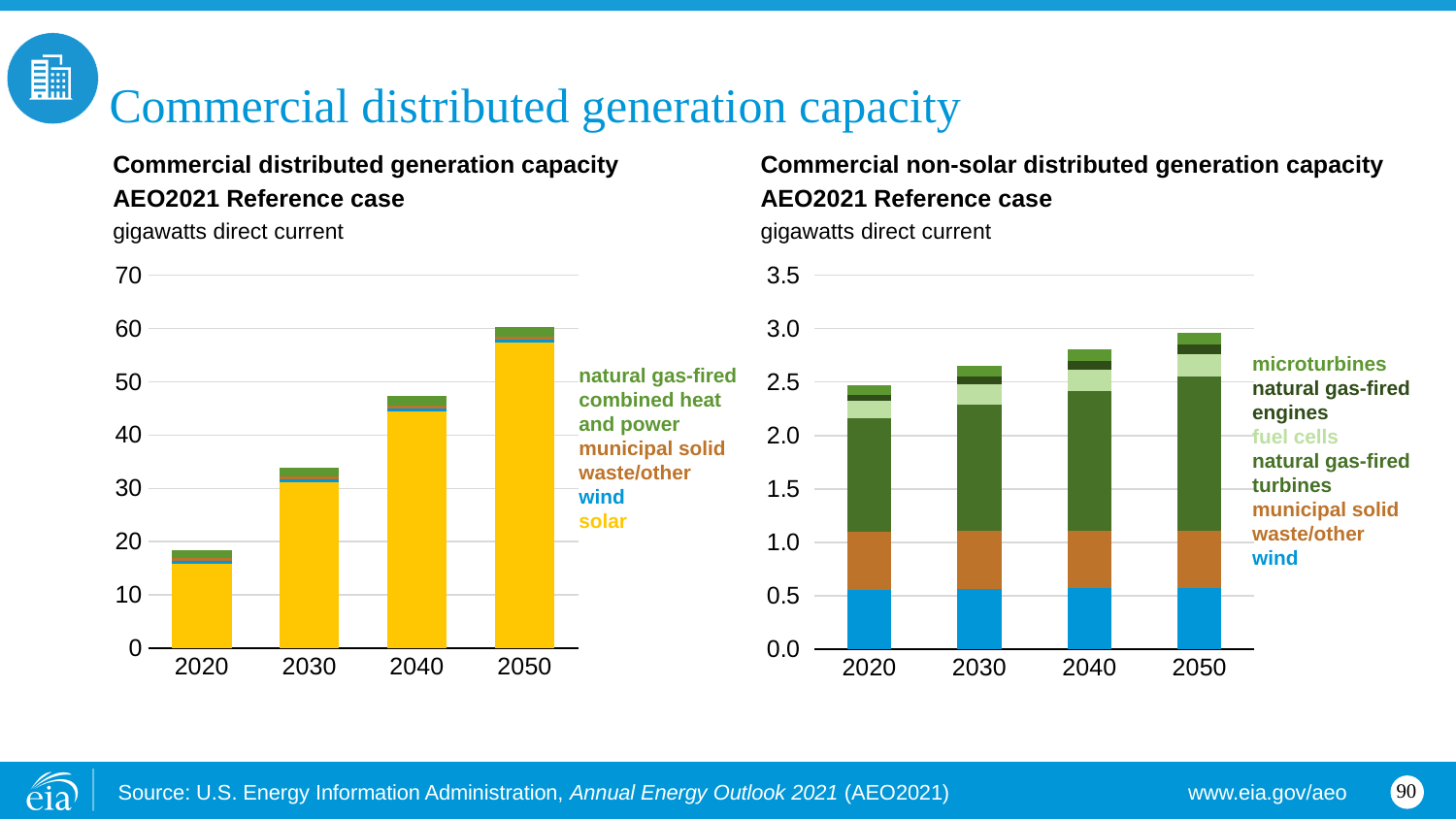
In the 'Commercial distributed generation capacity' chart on the left, which year has the lowest total capacity? 2020 In the 'Commercial distributed generation capacity' chart on the left, is the total for 2020 greater or less than 20? less In the 'Commercial distributed generation capacity' chart on the left, is the total for 2050 greater or less than 50? greater In the 'Commercial distributed generation capacity' chart on the left, which series makes up the largest part of each bar? solar What kind of chart is the 'Commercial distributed generation capacity' chart on the left? stacked bar chart What unit is given below the title of the 'Commercial non-solar distributed generation capacity' chart on the right? gigawatts direct current How many series does the legend list for the 'Commercial distributed generation capacity' chart on the left? 4 In the 'Commercial non-solar distributed generation capacity' chart on the right, do the total bar heights rise or fall from 2020 to 2050? rise In the 'Commercial distributed generation capacity' chart on the left, which year has the highest total capacity? 2050 How many series does the legend list for the 'Commercial non-solar distributed generation capacity' chart on the right? 6 How many years are shown on the x axis of the 'Commercial non-solar distributed generation capacity' chart on the right? 4